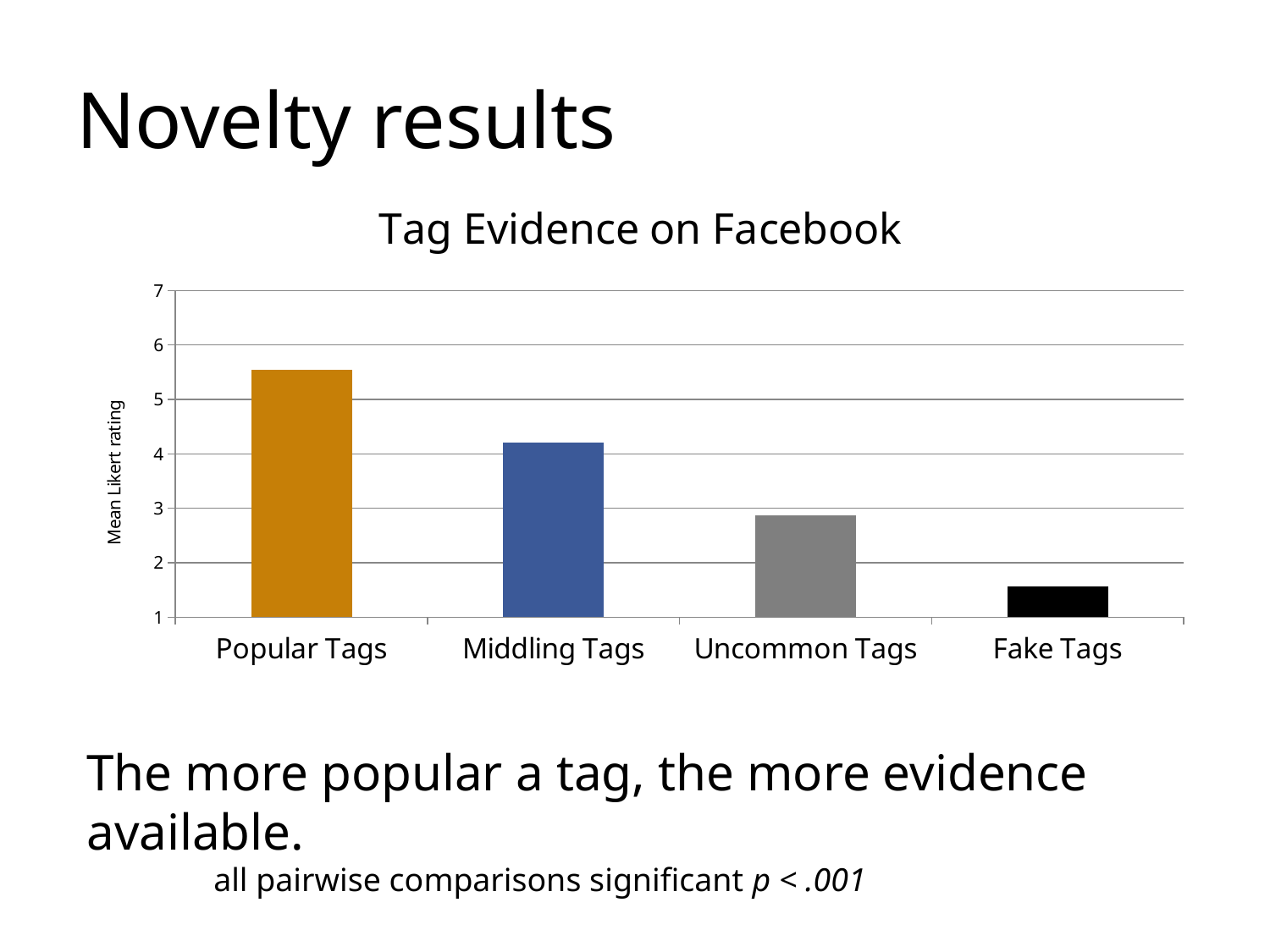
Which category has the lowest mean Likert rating? Fake Tags Which category has the highest mean Likert rating? Popular Tags Is the value for Middling Tags greater or less than 4? greater How many categories are plotted in the chart? 4 Is the value for Fake Tags greater or less than 2? less What is the label on the vertical axis of the chart? Mean Likert rating What type of chart is shown on the slide? bar chart What is the title of the chart? Tag Evidence on Facebook Is the value for Popular Tags greater or less than 5? greater Do the values rise or fall moving from Popular Tags to Fake Tags along the x axis? fall Which has a higher mean Likert rating, Middling Tags or Uncommon Tags? Middling Tags